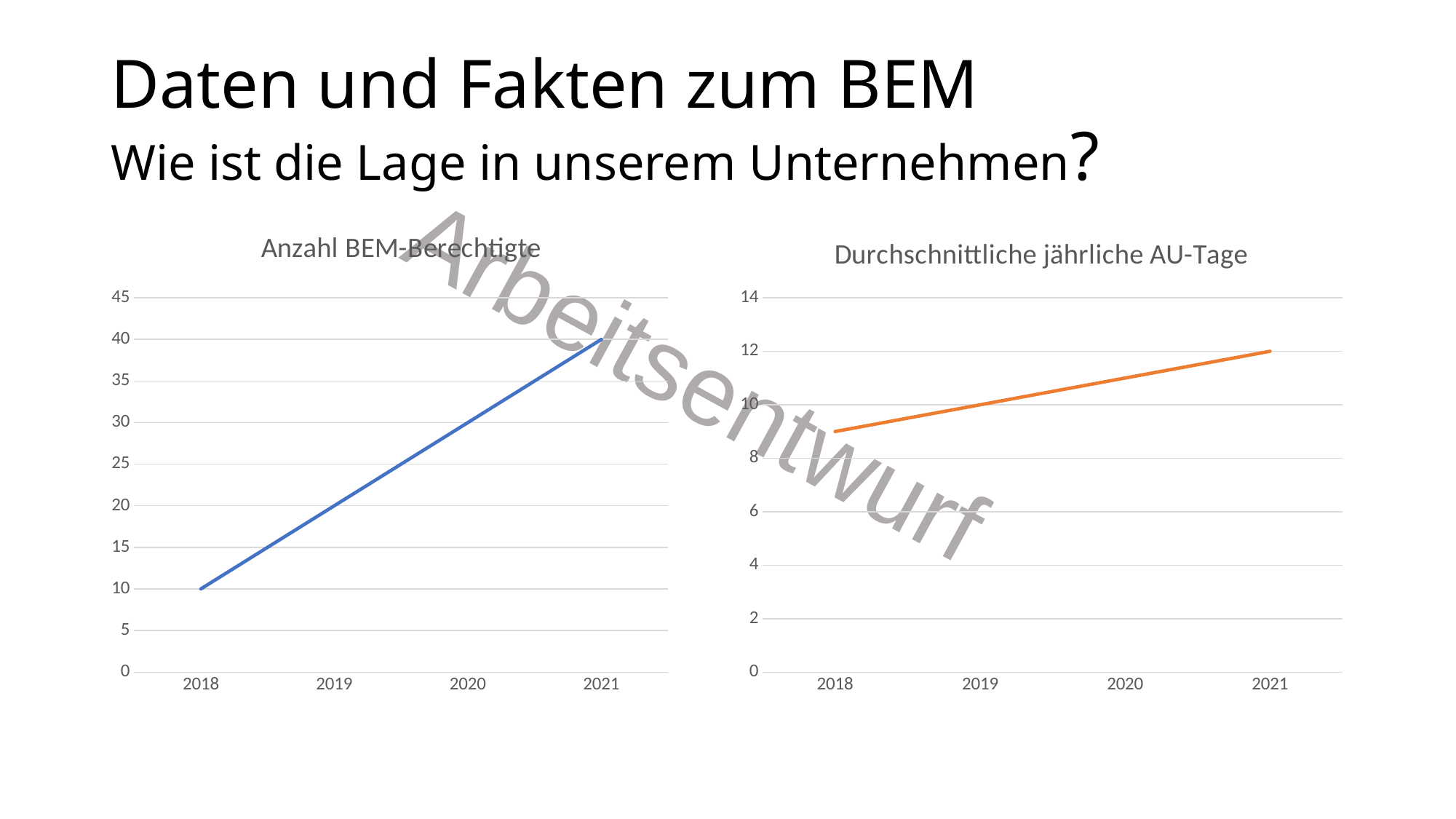
In the chart 'Anzahl BEM-Berechtigte', does the line rise or fall from 2018 to 2021? rise What is the title of the right chart on the slide? Durchschnittliche jährliche AU-Tage What kind of chart is the left chart titled 'Anzahl BEM-Berechtigte'? line chart How many years are labelled on the x axis of the chart 'Durchschnittliche jährliche AU-Tage'? 4 In the chart 'Durchschnittliche jährliche AU-Tage', is the value for 2018 greater or less than 10? less In the chart 'Durchschnittliche jährliche AU-Tage', does the line rise or fall from 2018 to 2021? rise In the chart 'Durchschnittliche jährliche AU-Tage', what is the value for 2021? 12 In the chart 'Anzahl BEM-Berechtigte', what is the value for 2021? 40 In the chart 'Durchschnittliche jährliche AU-Tage', is the value for 2018 greater or less than 8? greater In the chart 'Anzahl BEM-Berechtigte', what is the difference between the values for 2021 and 2018? 30 In the chart 'Anzahl BEM-Berechtigte', what is the value for 2018? 10 In the chart 'Anzahl BEM-Berechtigte', which year has the higher value, 2018 or 2021? 2021